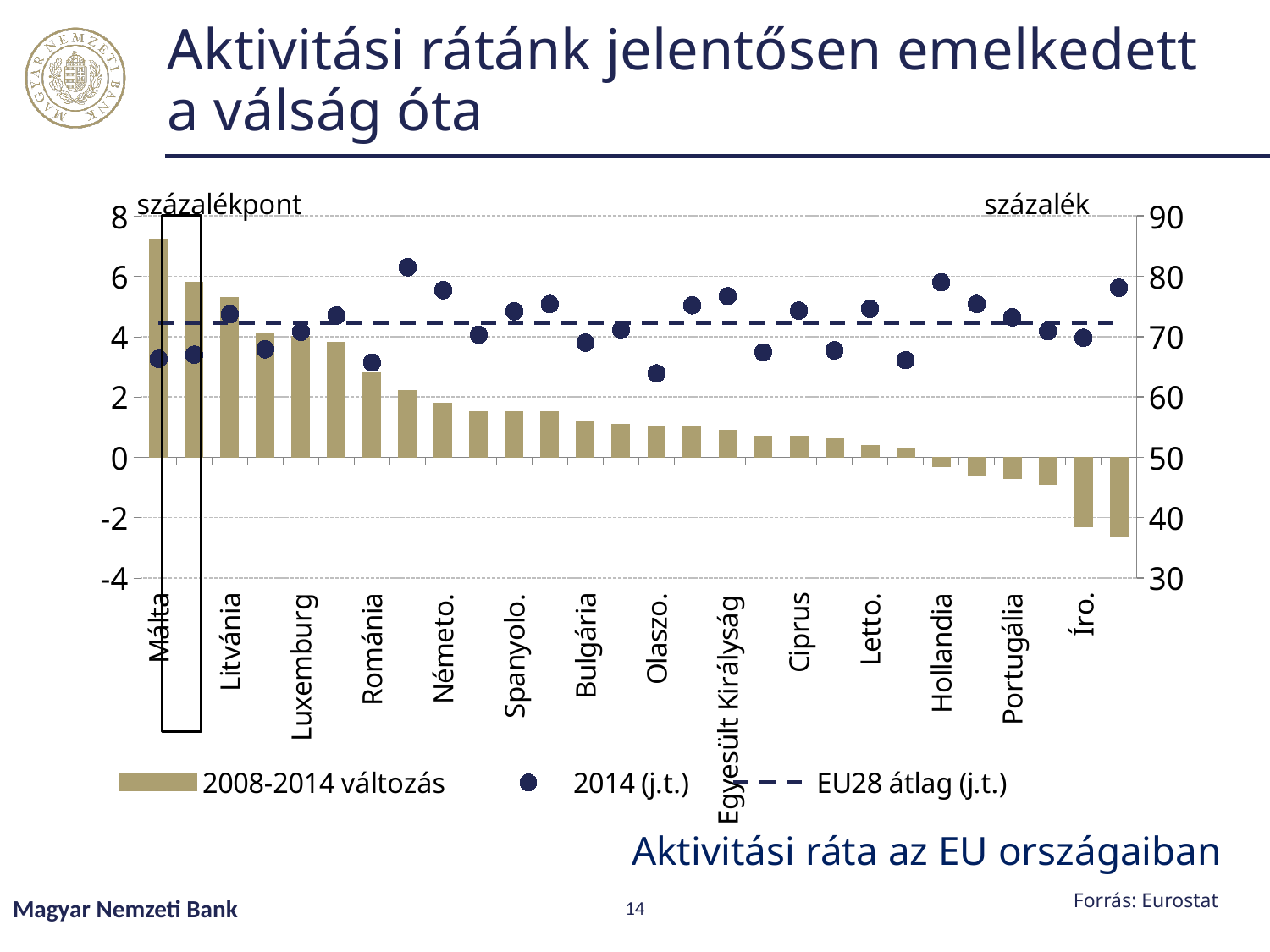
Is the 2014 (j.t.) value for Olaszo. greater or less than 70? less Do the 2008-2014 változás bars rise or fall from left to right along the x axis? fall Which has the larger 2008-2014 változás bar, Málta or Litvánia? Málta Is the 2008-2014 változás bar for Málta greater or less than 6? greater Is the 2008-2014 változás bar for Románia greater or less than 2? greater What is the title of the chart? Aktivitási ráta az EU országaiban How many series does the legend list? 3 Which has the higher 2014 (j.t.) value, Hollandia or Olaszo.? Hollandia Which category has the highest bar for 2008-2014 változás? Málta